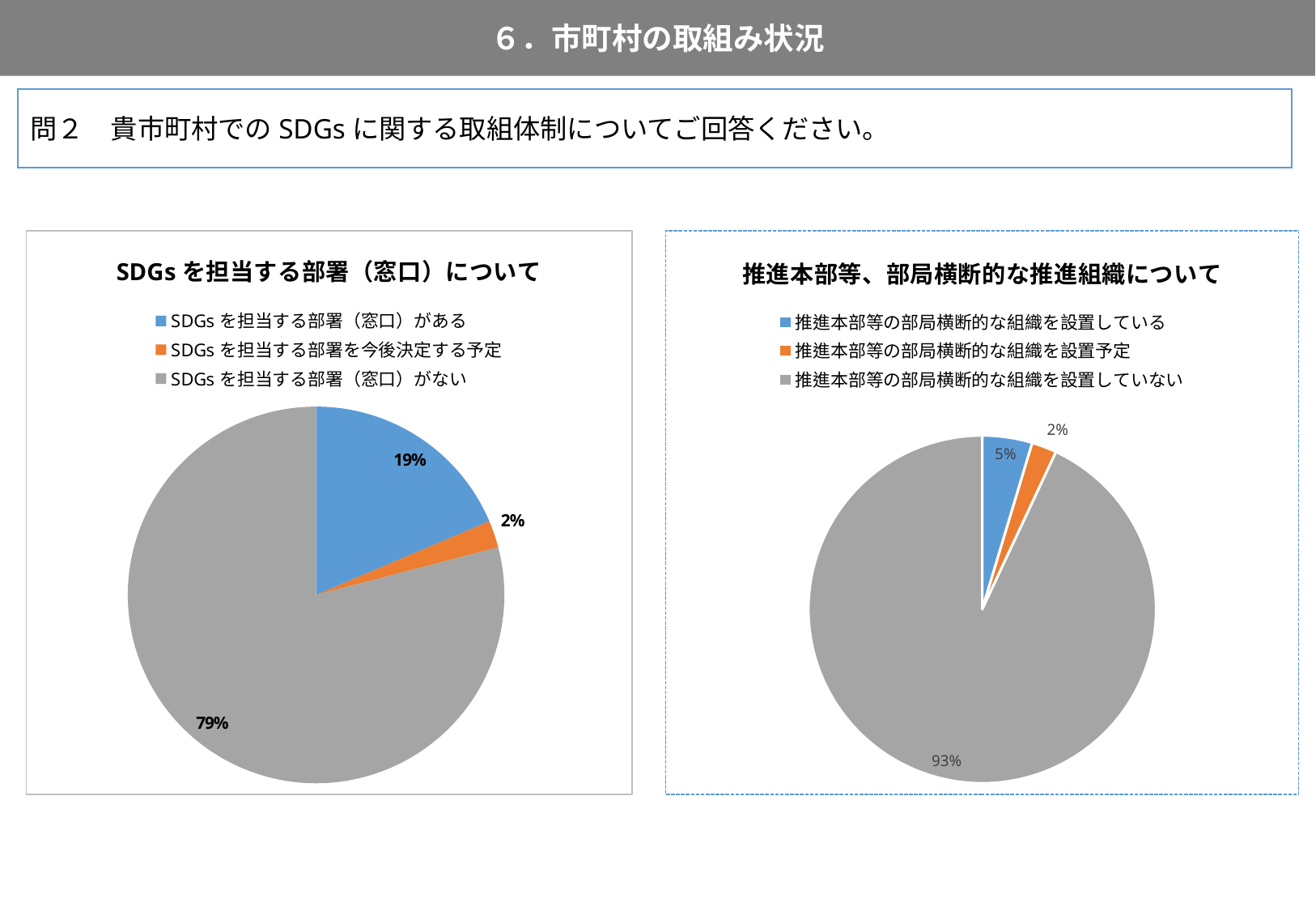
In the left chart 'SDGsを担当する部署（窓口）について', which category has the largest share? SDGsを担当する部署（窓口）がない In the right chart '推進本部等、部局横断的な推進組織について', what share is '推進本部等の部局横断的な組織を設置していない'? 93% In the right chart '推進本部等、部局横断的な推進組織について', which is larger: '推進本部等の部局横断的な組織を設置している' or '推進本部等の部局横断的な組織を設置予定'? 推進本部等の部局横断的な組織を設置している In the right chart '推進本部等、部局横断的な推進組織について', what share is '推進本部等の部局横断的な組織を設置予定'? 2% In the left chart 'SDGsを担当する部署（窓口）について', what share is 'SDGsを担当する部署（窓口）がない'? 79% How many entries does the legend of the right chart '推進本部等、部局横断的な推進組織について' list? 3 In the left chart 'SDGsを担当する部署（窓口）について', what is the difference in percentage points between 'SDGsを担当する部署（窓口）がない' and 'SDGsを担当する部署（窓口）がある'? 60 In the left chart 'SDGsを担当する部署（窓口）について', what share is 'SDGsを担当する部署（窓口）がある'? 19% In the right chart '推進本部等、部局横断的な推進組織について', what share is '推進本部等の部局横断的な組織を設置している'? 5% In the right chart '推進本部等、部局横断的な推進組織について', which category has the smallest share? 推進本部等の部局横断的な組織を設置予定 What type of chart is the left chart 'SDGsを担当する部署（窓口）について'? Pie chart In the left chart 'SDGsを担当する部署（窓口）について', what share is 'SDGsを担当する部署を今後決定する予定'? 2%